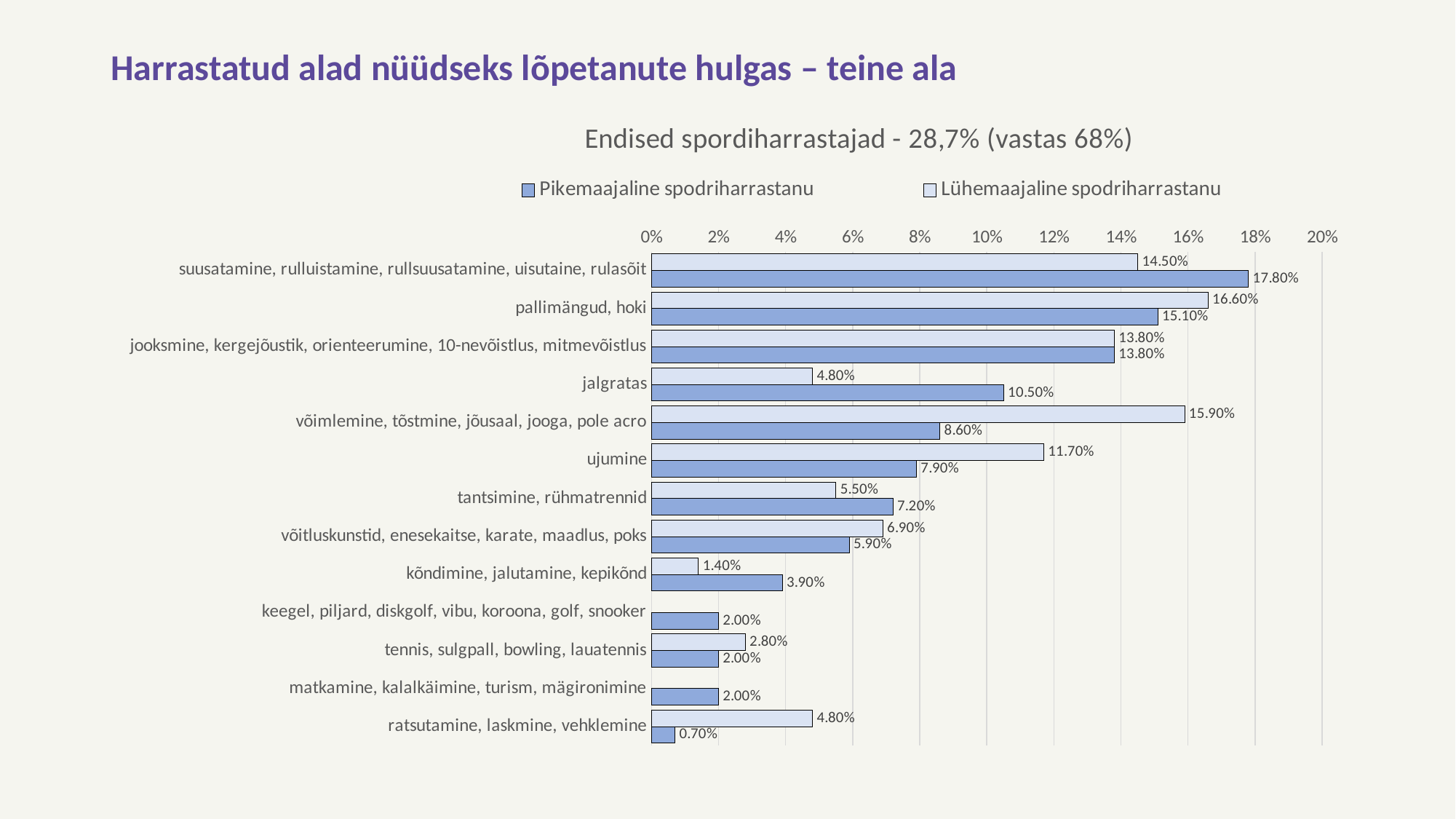
How many categories are shown on the chart? 13 Is the Pikemaajaline spodriharrastanu value for ujumine greater or less than 8%? less For pallimängud, hoki, which series has the larger value? Lühemaajaline spodriharrastanu What is the value for Lühemaajaline spodriharrastanu for ujumine? 11.70% What type of chart is shown on the slide? bar chart What is the value for Lühemaajaline spodriharrastanu for võimlemine, tõstmine, jõusaal, jooga, pole acro? 15.90% Which category has the lowest value for Pikemaajaline spodriharrastanu? ratsutamine, laskmine, vehklemine How many series does the legend list? 2 What is the value for Pikemaajaline spodriharrastanu for jalgratas? 10.50% What is the difference between the Pikemaajaline and Lühemaajaline values for jalgratas? 5.70% What is the title of the chart? Endised spordiharrastajad - 28,7% (vastas 68%) Which category has the highest value for Pikemaajaline spodriharrastanu? suusatamine, rulluistamine, rullsuusatamine, uisutaine, rulasõit